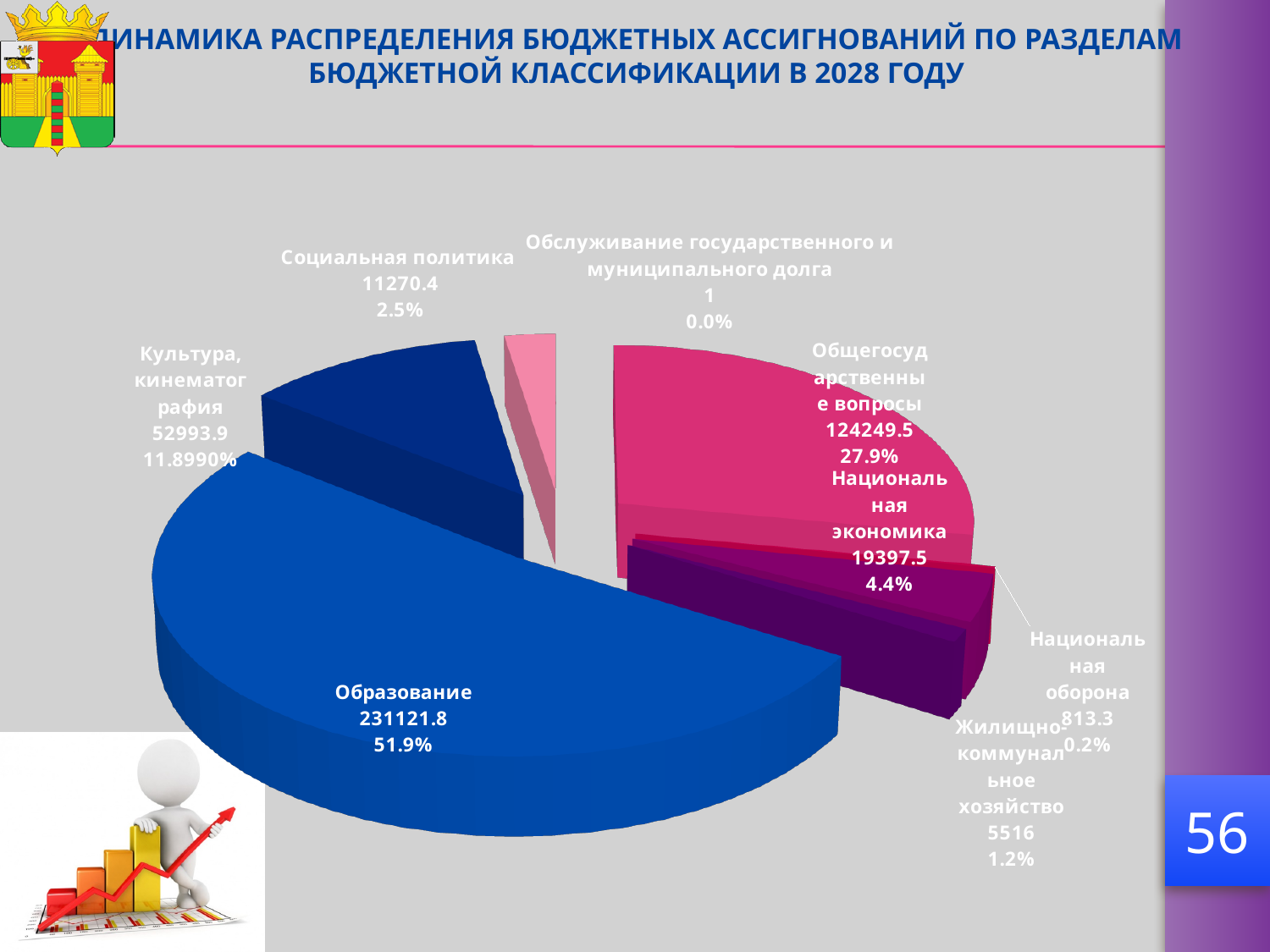
What is the value shown for Национальная экономика? 19397.5 Which is larger, the value for Социальная политика or the value for Жилищно-коммунальное хозяйство? Социальная политика What is the difference between the values for Образование and Общегосударственные вопросы? 106872.3 What kind of chart is shown on the slide? pie chart What percentage is shown for Культура, кинематография? 11.8990% What is the value shown for Общегосударственные вопросы? 124249.5 How many categories are shown in the pie chart? 8 What percentage is shown for Национальная оборона? 0.2% Which category has the largest share of the pie? Образование Which category has the smallest value in the pie chart? Обслуживание государственного и муниципального долга What is the value shown for Образование? 231121.8 What share of the pie does Образование represent? 51.9%